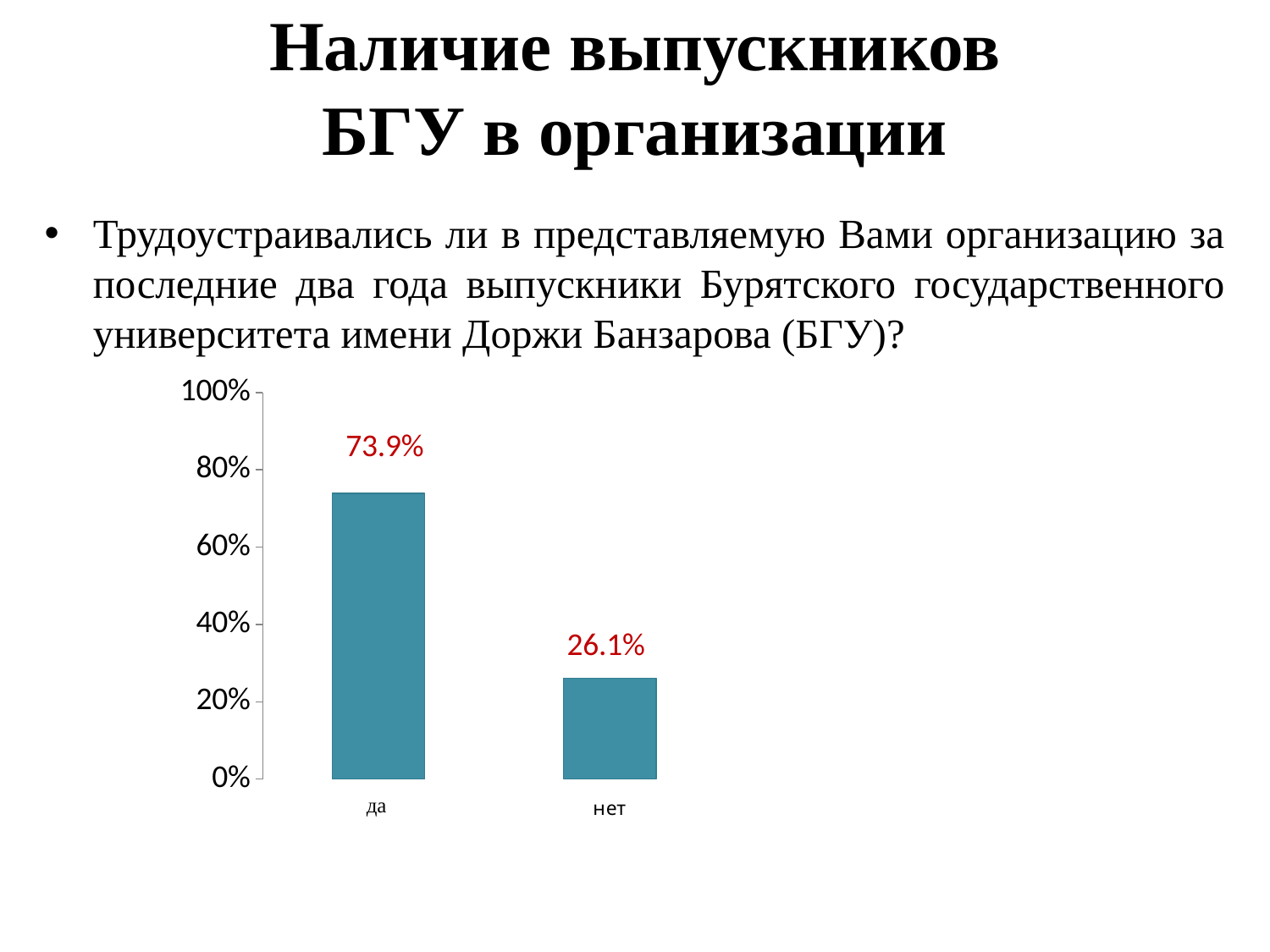
Is the value for "да" greater or less than 60%? greater What is the highest value shown on the y axis? 100% How many categories are shown on the x axis? 2 What kind of chart is shown on the slide? bar chart Which is larger, the value for "да" or the value for "нет"? да What is the value for "нет"? 26.1% Which category has the lowest value? нет What is the value for "да"? 73.9% What is the difference between the values for "да" and "нет"? 47.8% What colour are the bars in the chart? teal blue Which category has the highest value? да Is the value for "нет" greater or less than 40%? less